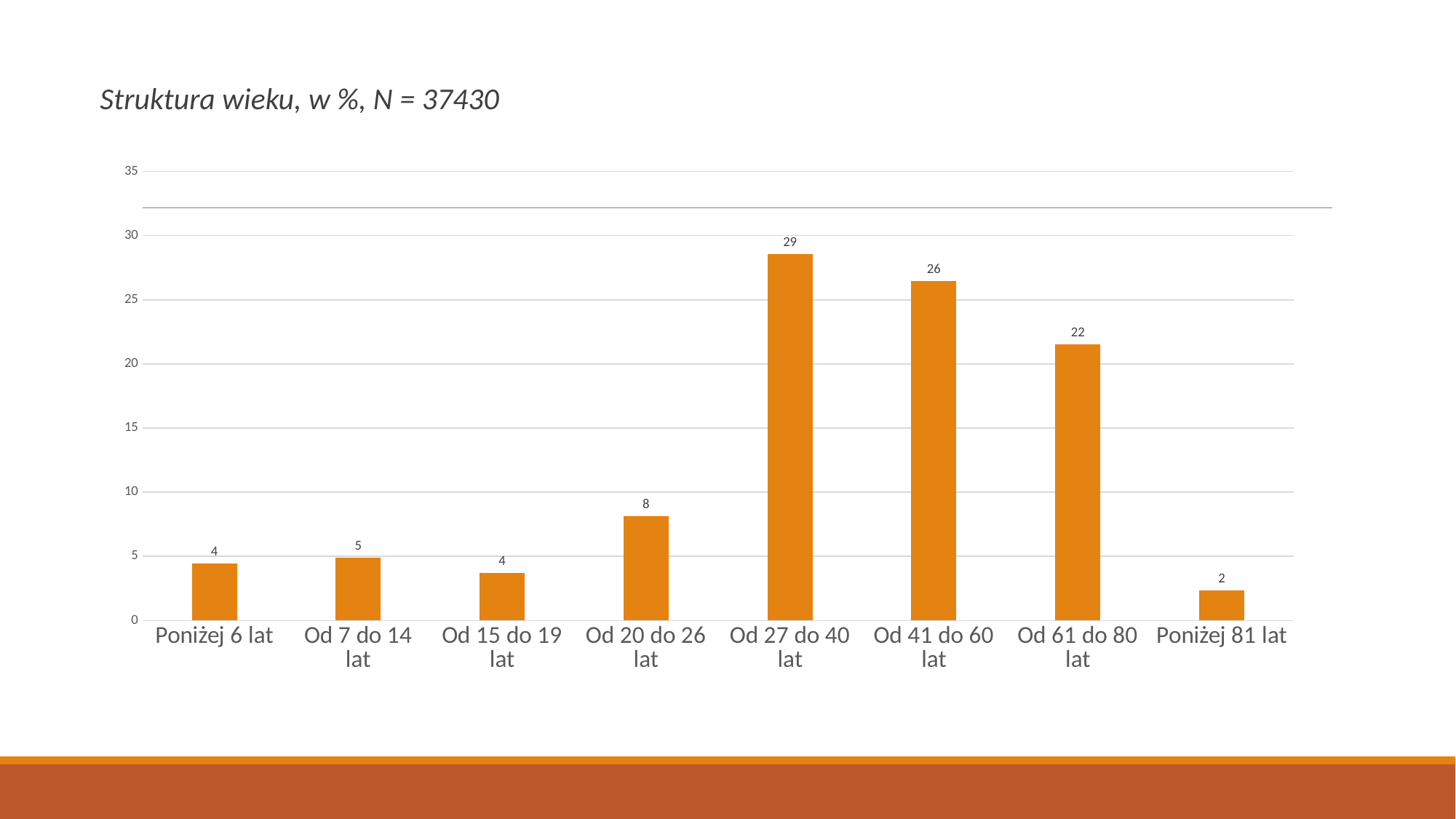
How many age categories are shown on the chart? 8 Which is larger, the value for Od 41 do 60 lat or the value for Od 61 do 80 lat? Od 41 do 60 lat What kind of chart is shown on the slide? bar chart What is the difference between the values for Od 27 do 40 lat and Od 41 do 60 lat? 3 What is the value for Od 61 do 80 lat? 22 Which age category has the highest value? Od 27 do 40 lat What is the value for Poniżej 81 lat? 2 What is the title of the chart? Struktura wieku, w %, N = 37430 Is the value for Od 61 do 80 lat greater or less than 20? greater Which age category has the lowest value? Poniżej 81 lat What is the value for Od 27 do 40 lat? 29 What is the value for Od 20 do 26 lat? 8